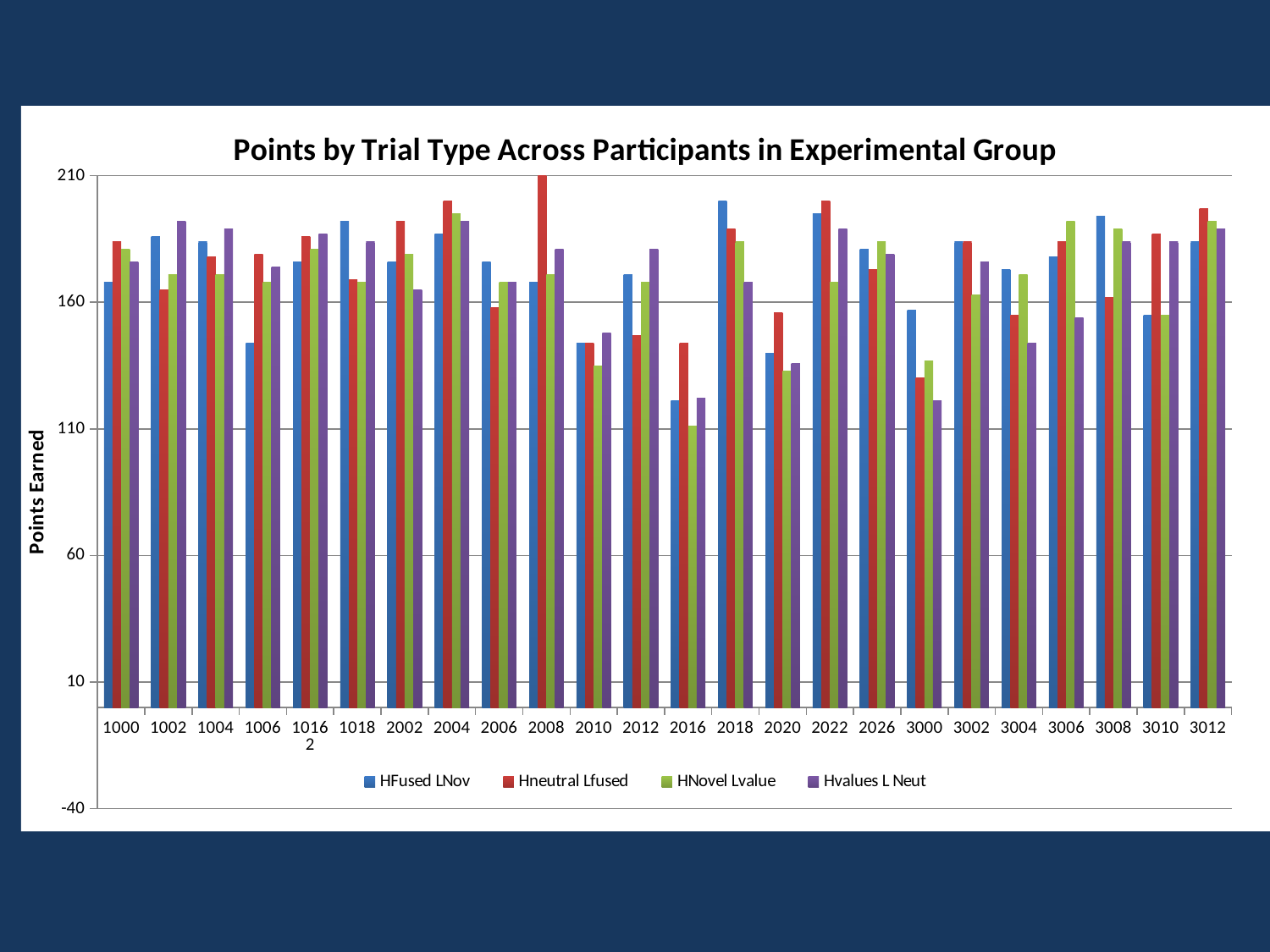
Is the HFused LNov value for participant 2016 greater or less than 160? less How many participant categories are shown along the x axis? 24 What is the title of the chart? Points by Trial Type Across Participants in Experimental Group Which participant has the lowest HNovel Lvalue bar? 2016 What kind of chart is shown on the slide? bar chart What is the label on the vertical axis? Points Earned Is the Hneutral Lfused value for participant 2008 greater or less than 160? greater Is the Hvalues L Neut value for participant 2020 greater or less than 160? less How many series does the legend list? 4 For participant 2008, which is larger: the HFused LNov bar or the Hneutral Lfused bar? Hneutral Lfused For participant 3000, which is larger: the HFused LNov bar or the Hneutral Lfused bar? HFused LNov Which participant has the highest Hneutral Lfused bar? 2008